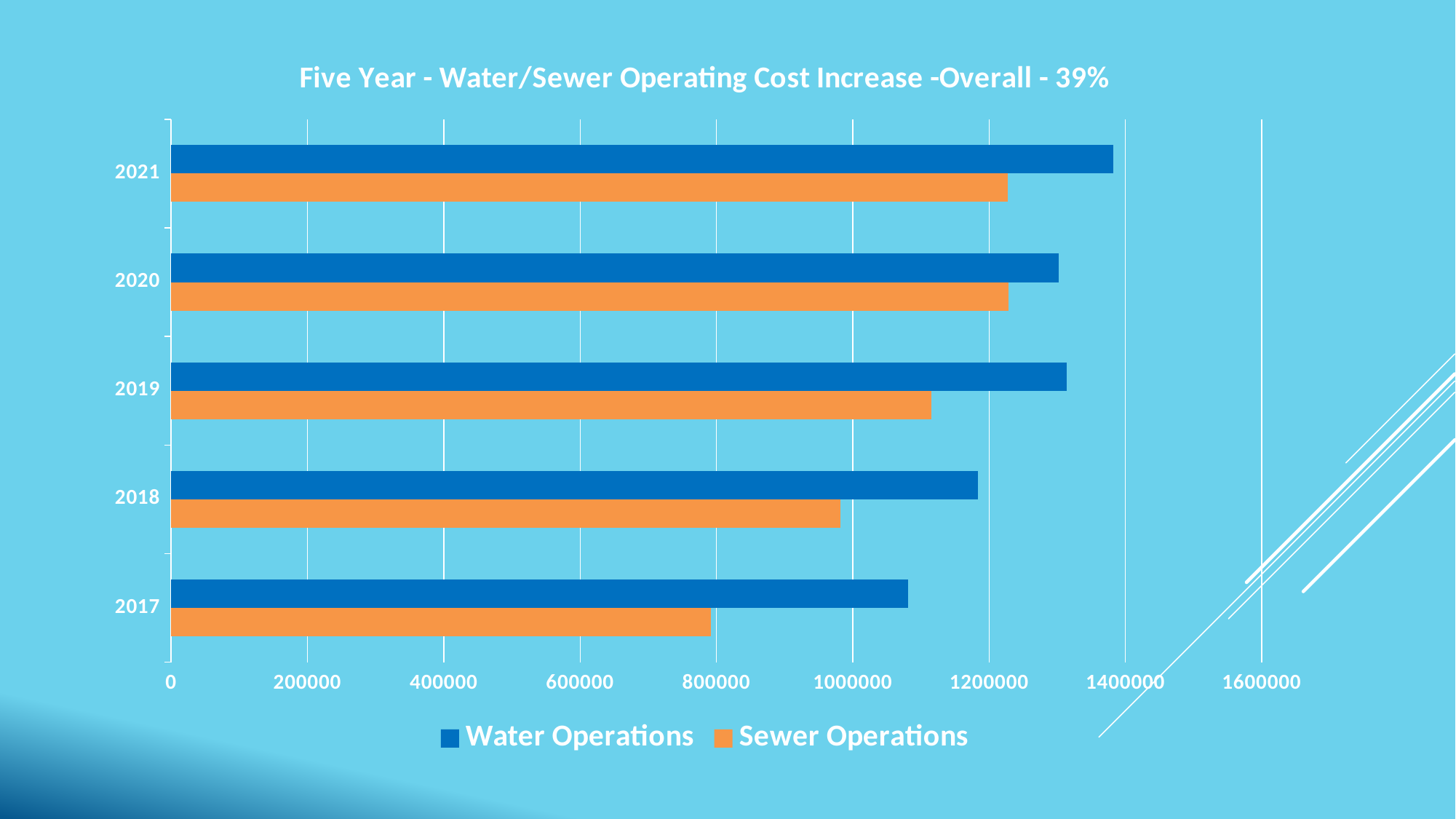
Is the Water Operations value for 2021 greater or less than 1200000? greater Is the Water Operations value for 2017 greater or less than 1000000? greater Which year has the lowest Sewer Operations value? 2017 Is the Sewer Operations value for 2019 greater or less than 1000000? greater Which year has the highest Water Operations value? 2021 Which year has the lowest Water Operations value? 2017 What is the title of the chart? Five Year - Water/Sewer Operating Cost Increase -Overall - 39% What kind of chart is shown on the slide? bar chart How many years are shown on the chart? 5 In 2017, which is larger: Water Operations or Sewer Operations? Water Operations How many series does the legend list? 2 Which is larger: Sewer Operations in 2019 or Sewer Operations in 2018? 2019